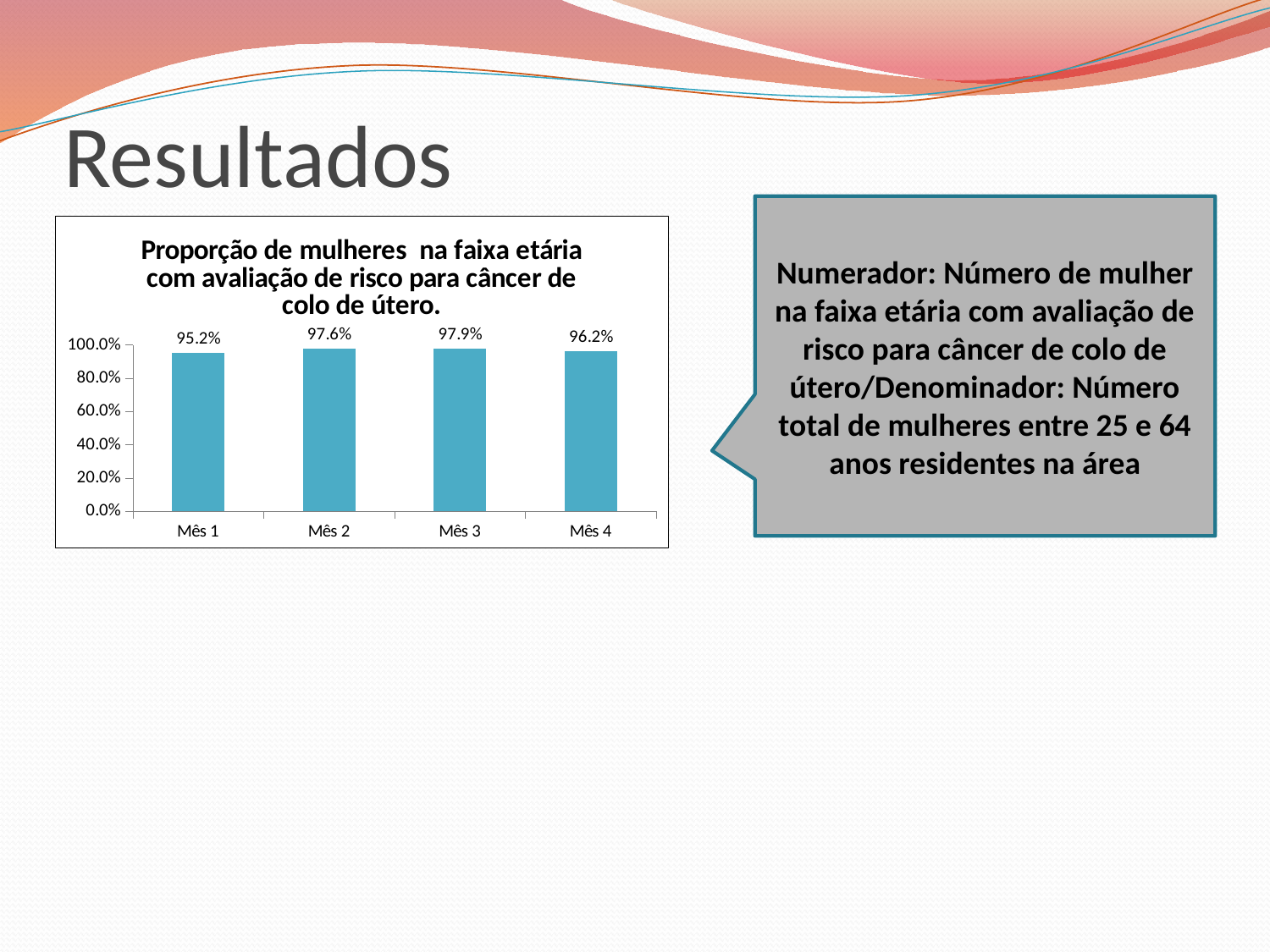
Which month has the highest value? Mês 3 What is the title of the chart? Proporção de mulheres na faixa etária com avaliação de risco para câncer de colo de útero. What is the value for Mês 1? 95.2% What kind of chart is shown on the slide? Bar chart How many months are shown on the x axis? 4 What is the value for Mês 3? 97.9% What is the value for Mês 2? 97.6% Which is larger, the value for Mês 2 or the value for Mês 4? Mês 2 What is the difference between the values for Mês 2 and Mês 1? 2.4% What is the value for Mês 4? 96.2% Which month has the lowest value? Mês 1 What is the difference between the values for Mês 3 and Mês 4? 1.7%